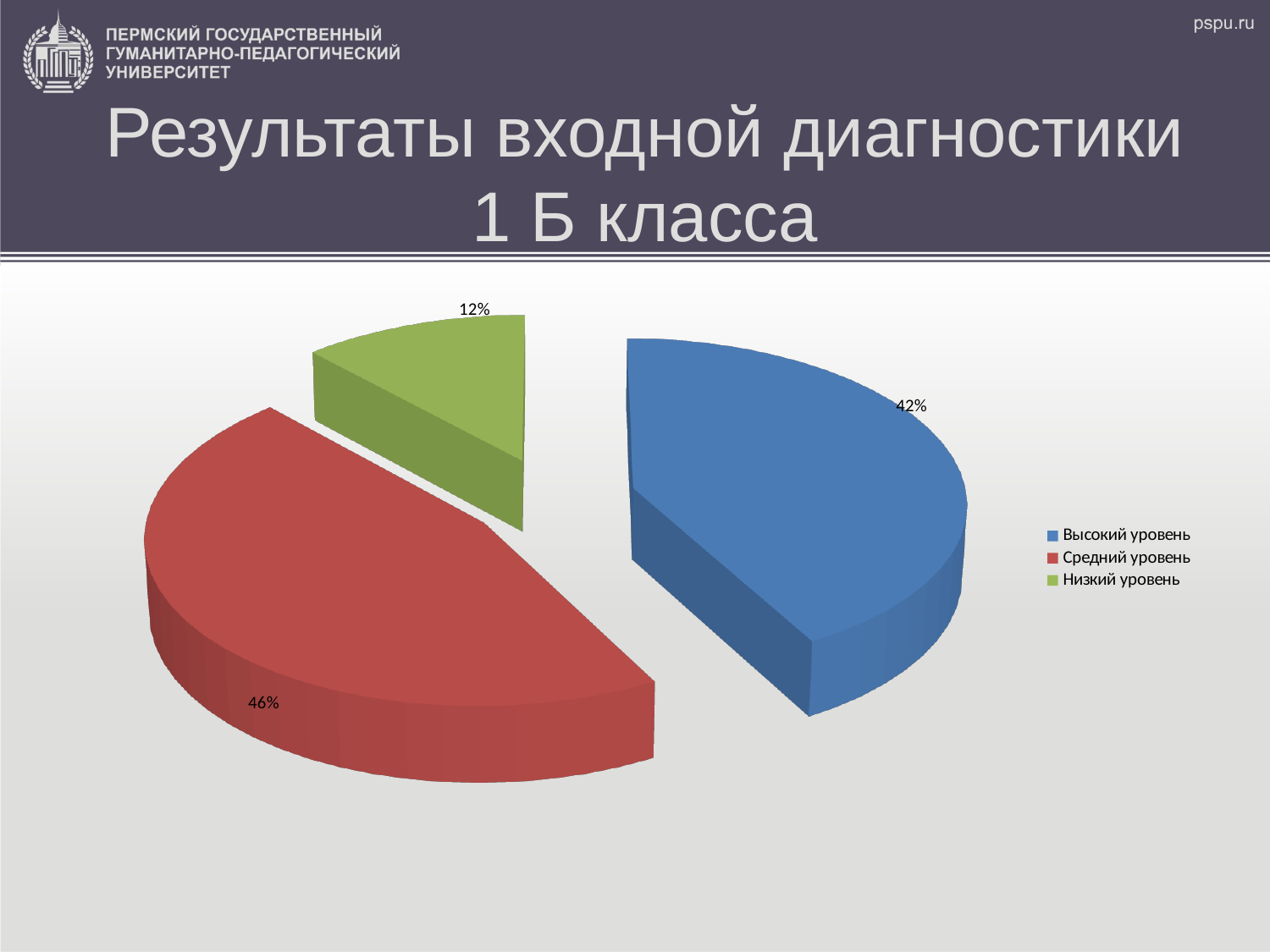
Which category has the largest slice of the pie? Средний уровень How many slices does the pie chart have? 3 What is the difference between the shares of Средний уровень and Низкий уровень? 34% What share of the pie does Низкий уровень have? 12% What share of the pie does Средний уровень have? 46% What kind of chart is shown on the slide? pie chart How many entries does the legend list? 3 Which is larger, the share of Высокий уровень or the share of Низкий уровень? Высокий уровень What colour is the slice for Низкий уровень? green Which category has the smallest slice of the pie? Низкий уровень What is the difference between the shares of Высокий уровень and Низкий уровень? 30% What share of the pie does Высокий уровень have? 42%